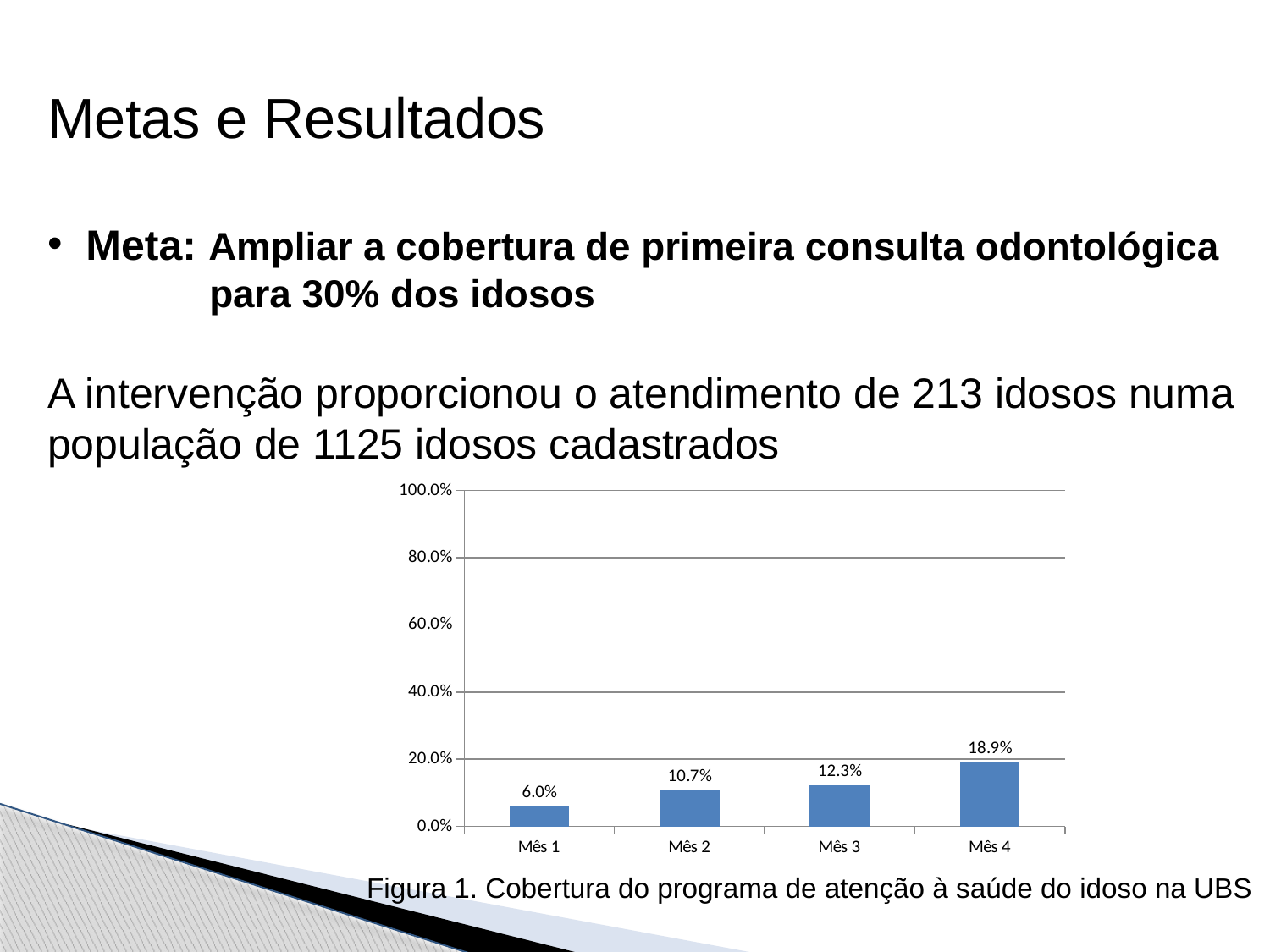
Which month has the lowest value? Mês 1 What is the difference between the values for Mês 3 and Mês 2? 1.6% What is the difference between the values for Mês 4 and Mês 1? 12.9% Which month has the highest value? Mês 4 What is the value for Mês 3? 12.3% What is the value for Mês 4? 18.9% What kind of chart is shown? bar chart How many months are shown on the x axis? 4 What is the value for Mês 2? 10.7% Is the value for Mês 4 greater or less than 20.0%? less Which is larger, the value for Mês 2 or the value for Mês 3? Mês 3 What is the value for Mês 1? 6.0%